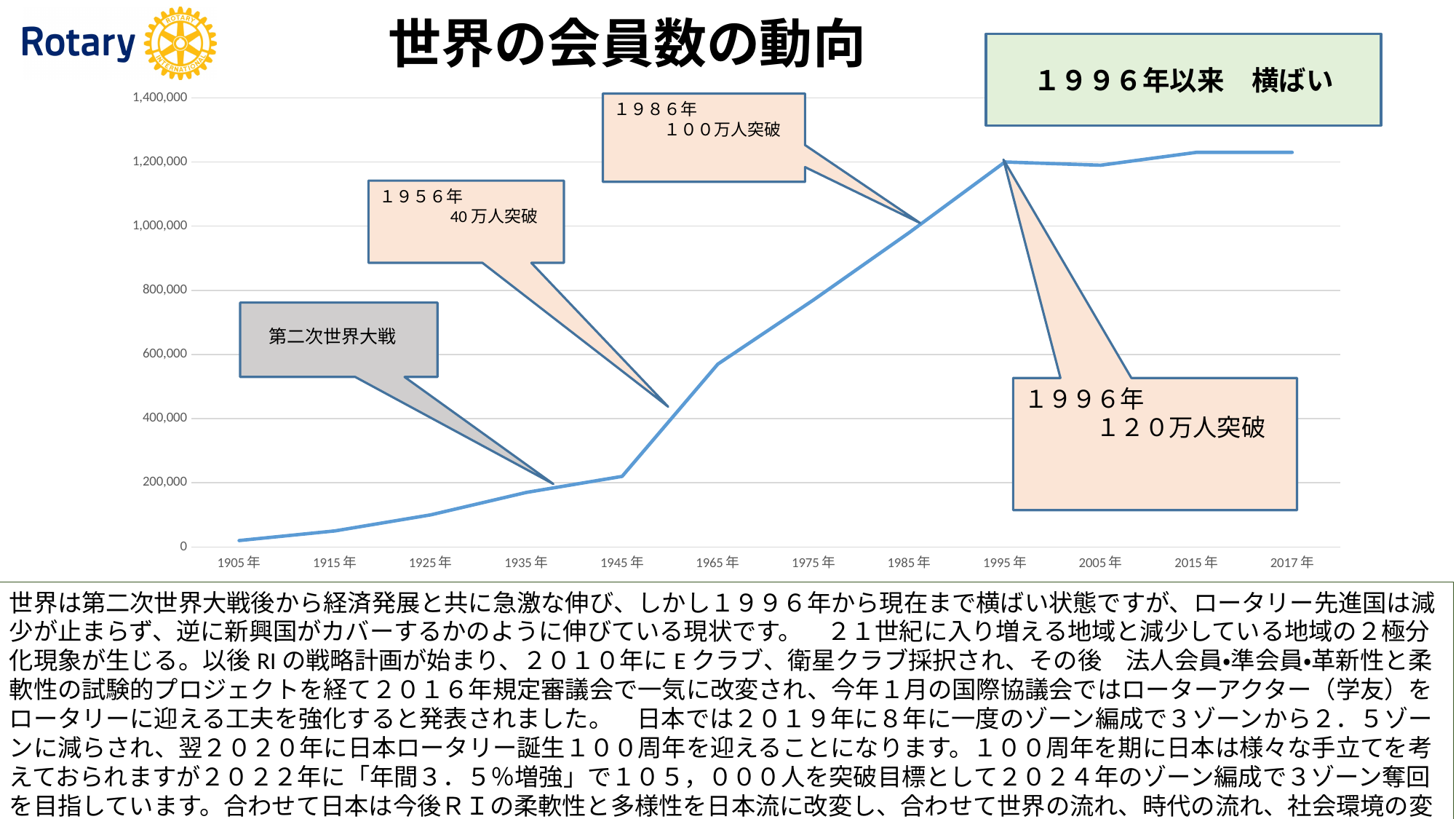
Is the value for 1965年 greater or less than 600,000? less Do the values rise or fall from 1905年 to 1995年? rise What is the title of the chart? 世界の会員数の動向 Is the value for 1965年 greater or less than 400,000? greater According to the callout on the chart, in which year did membership exceed 1,000,000 (１００万人突破)? 1986年 What kind of chart is shown on the slide? line chart Which has the larger value, 1945年 or 1965年? 1965年 How many year categories are shown on the x axis of the chart? 12 Is the value for 1935年 greater or less than 200,000? less Which year on the x axis has the lowest membership value? 1905年 Which has the larger value, 1975年 or 1985年? 1985年